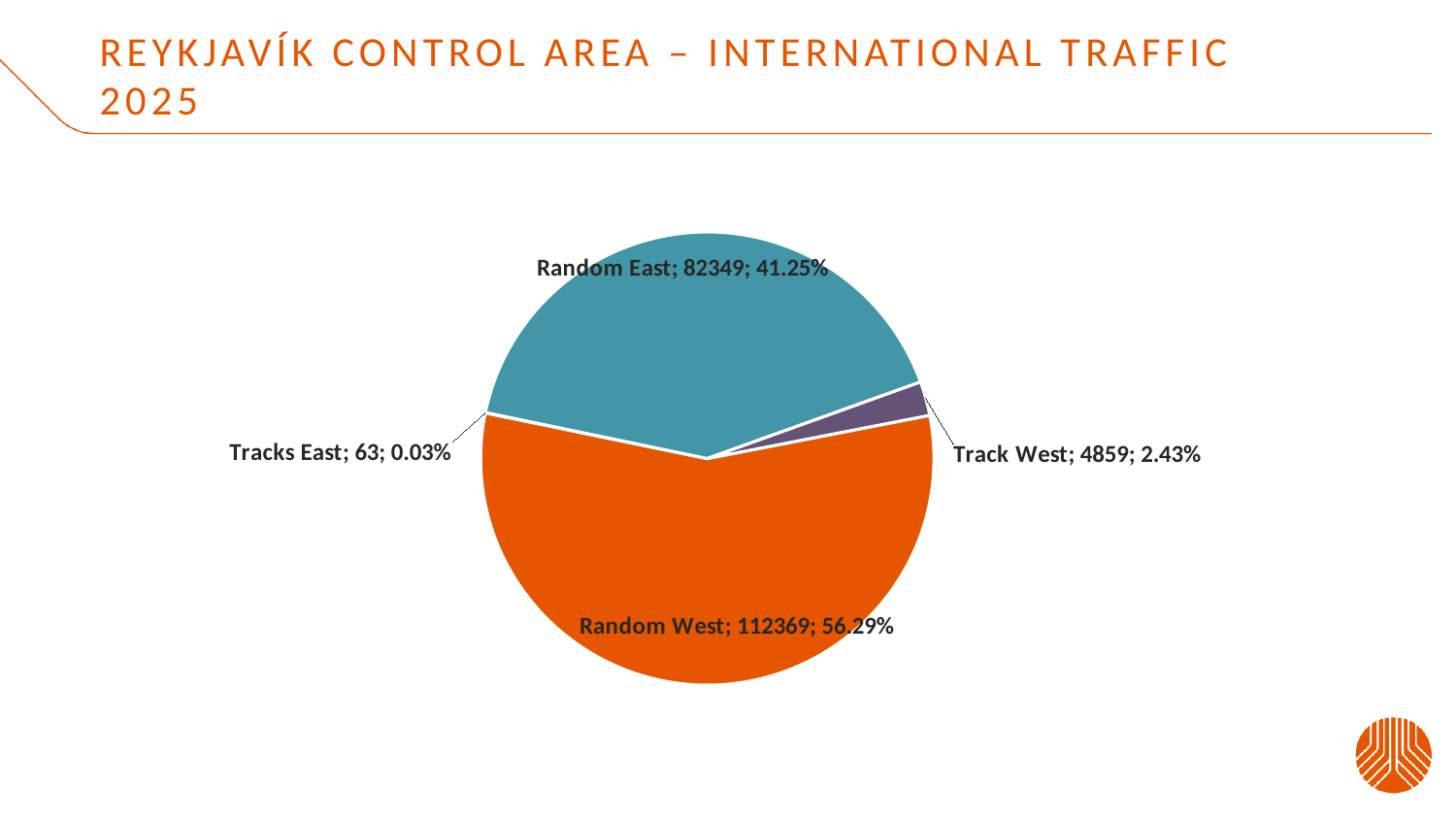
Which category has the largest slice? Random West What kind of chart is shown on the slide? pie chart Which category has the smallest slice? Tracks East What share of the pie does Track West represent? 2.43% What is the title of the slide containing the chart? Reykjavík Control Area – International Traffic 2025 How many slices does the pie chart have? 4 Which is larger, the value for Track West or the value for Tracks East? Track West What share of the pie does Random West represent? 56.29% What is the value for Random East? 82349 What is the difference between the values for Random West and Random East? 30020 What is the value for Track West? 4859 What is the value for Tracks East? 63